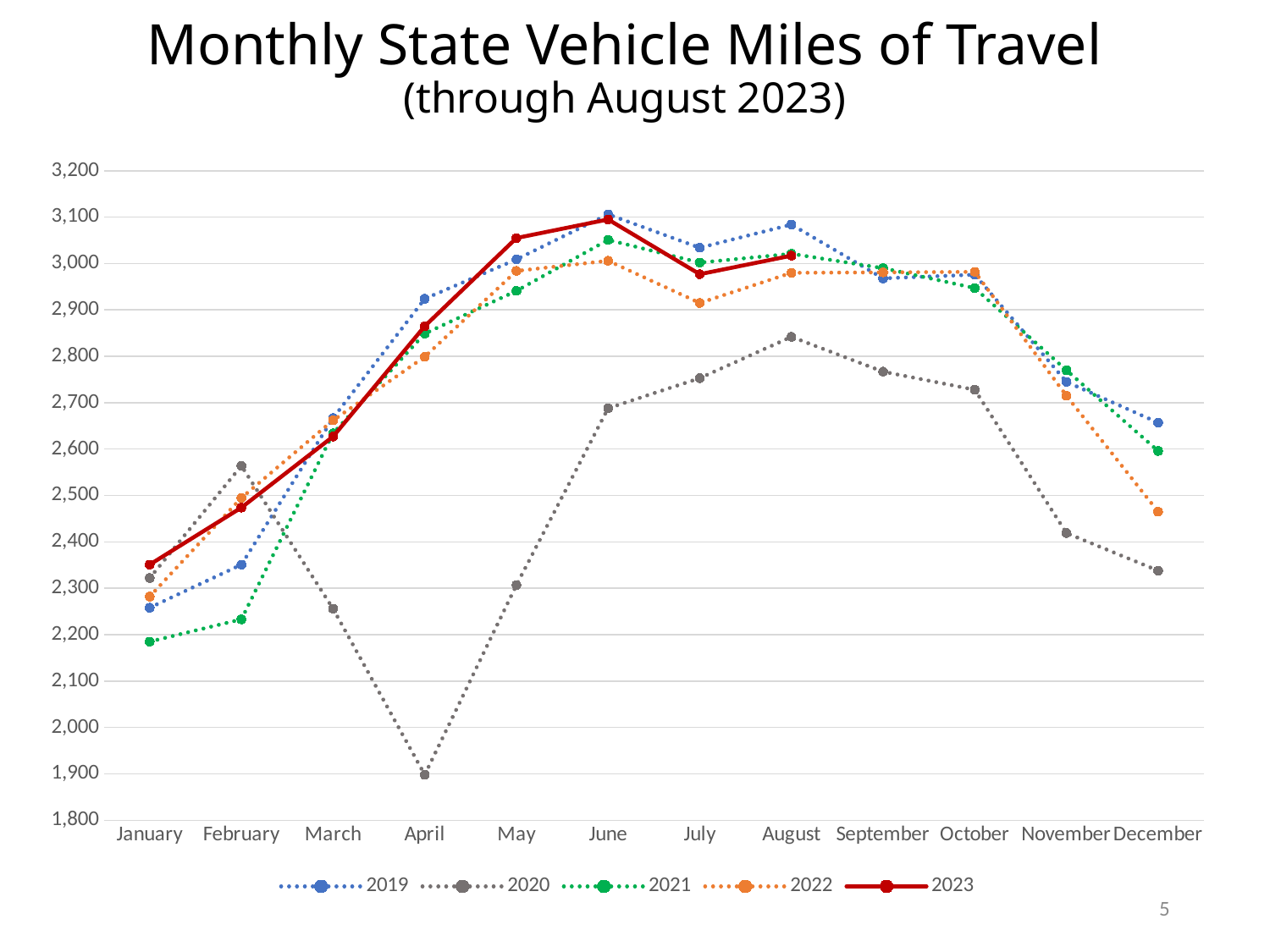
Is the 2020 value for April greater or less than 2,000? less Which month has the lowest value for the 2019 series? January Is the 2022 value for December greater or less than 2,500? less Which is larger in April, the 2019 value or the 2020 value? 2019 Which month has the highest value for the 2020 series? August How many months are shown along the x axis? 12 Does the 2023 series rise or fall from January to June? rise Which month has the lowest value for the 2020 series? April Is the 2023 value for May greater or less than 3,000? greater Which series is drawn as a solid line rather than a dotted line? 2023 How many series does the legend list? 5 What kind of chart is shown on the slide? line chart